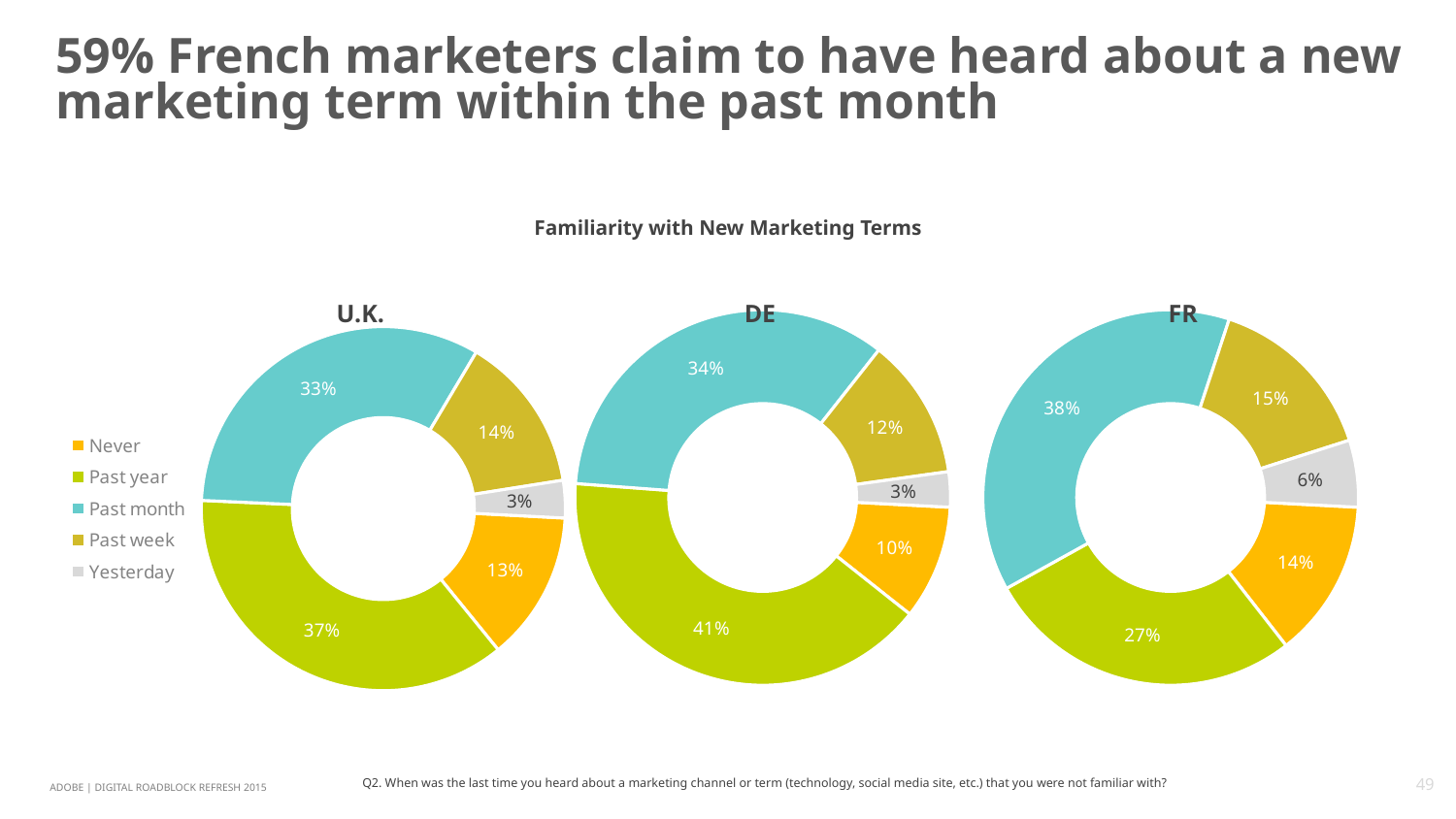
What is the difference between the Past year shares in the DE chart and the FR chart? 14% In the FR chart, what percentage is shown for Yesterday? 6% Which is larger: the Never share in the U.K. chart or the Never share in the FR chart? FR How many series does the legend list? 5 What is the title shown above the three charts? Familiarity with New Marketing Terms What kind of chart is used for the U.K., DE and FR data? Pie (donut) chart How many pie charts are shown on the slide? 3 In the U.K. chart, which category has the smallest share? Yesterday In the DE chart, what percentage is shown for Never? 10% In the U.K. chart, what percentage is shown for Past year? 37% In the FR chart, what percentage is shown for Past month? 38% In the DE chart, which category has the largest share? Past year